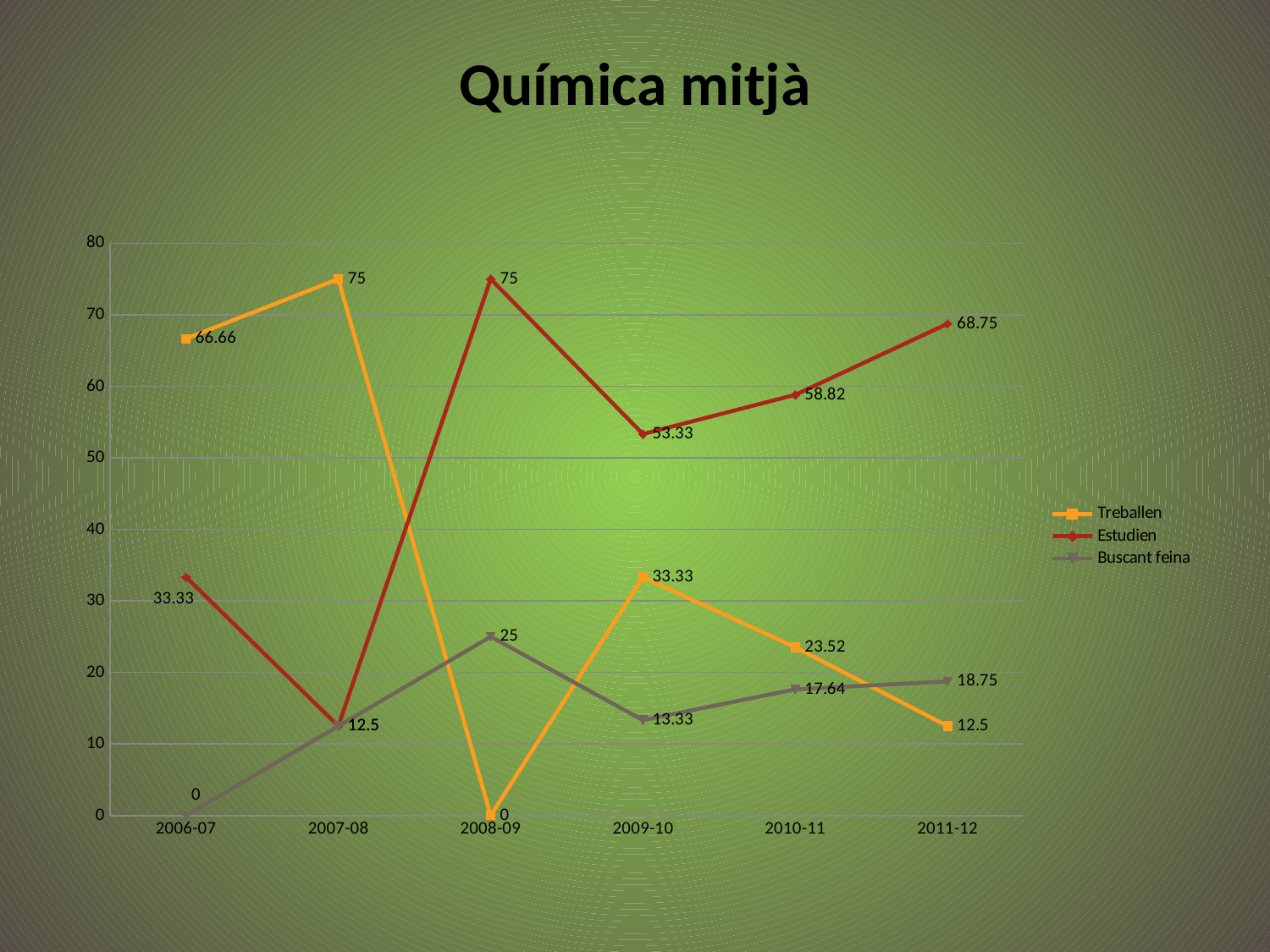
How many series does the legend list? 3 How many years are shown on the x axis? 6 What is the value for Estudien in 2011-12? 68.75 In which year is the Treballen series at its lowest? 2008-09 Which is larger in 2010-11, Estudien or Buscant feina? Estudien What is the value for Buscant feina in 2008-09? 25 What is the difference between Estudien and Treballen in 2009-10? 20 In which year is the Estudien series at its highest? 2008-09 What is the title of the chart? Química mitjà What type of chart is shown on the slide? line chart What is the value for Treballen in 2010-11? 23.52 What is the value for Treballen in 2006-07? 66.66